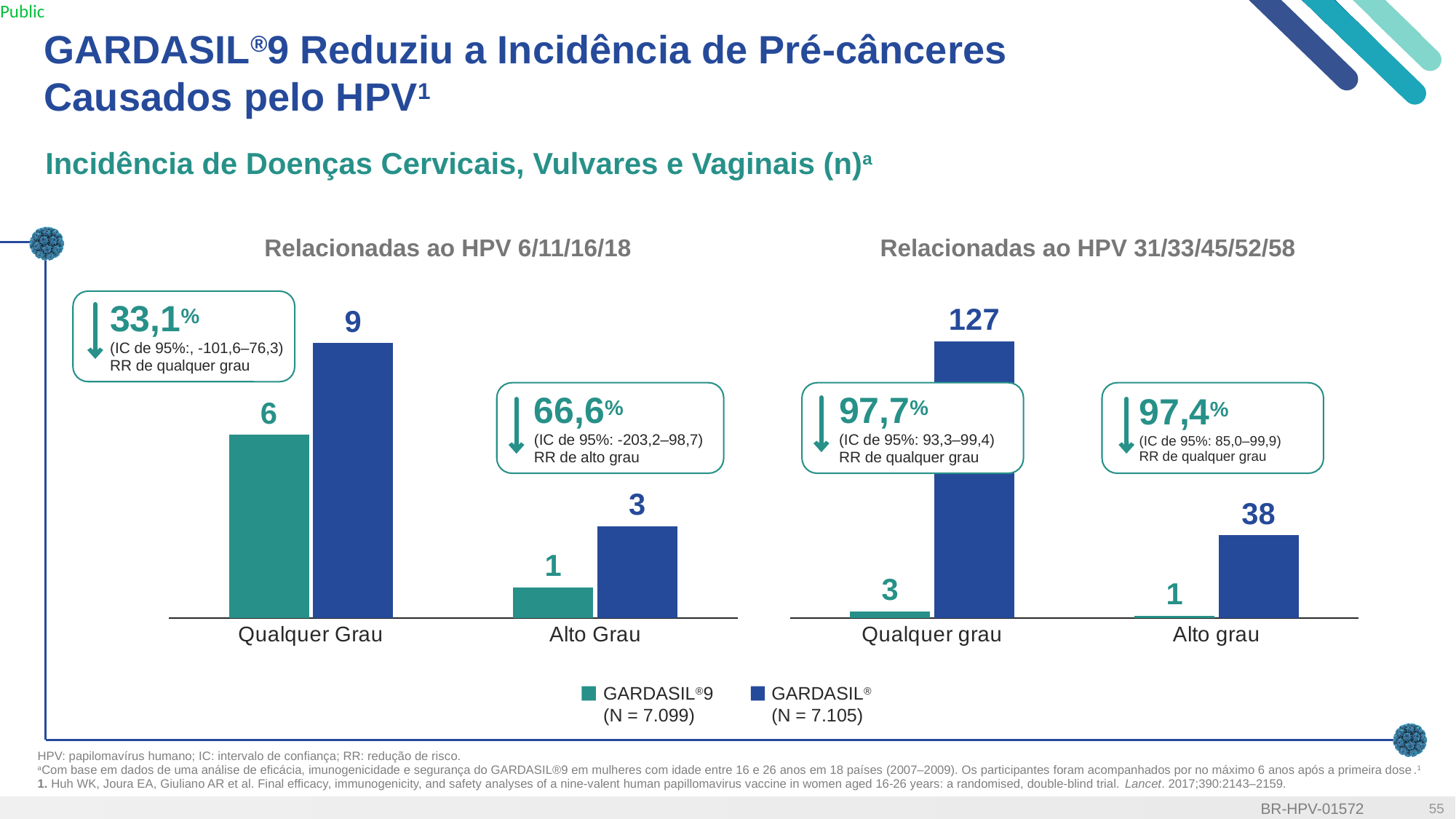
In the chart 'Relacionadas ao HPV 6/11/16/18', what is the value for GARDASIL®9 in the 'Qualquer Grau' category? 6 In the chart 'Relacionadas ao HPV 31/33/45/52/58', what is the value for GARDASIL® in the 'Qualquer grau' category? 127 In the chart 'Relacionadas ao HPV 31/33/45/52/58', which bar is the highest? GARDASIL® in Qualquer grau (127) How many series does the legend list for the charts on this slide? 2 What type of chart is used for 'Relacionadas ao HPV 31/33/45/52/58'? Bar chart In the chart 'Relacionadas ao HPV 6/11/16/18', what is the difference between GARDASIL® and GARDASIL®9 in the 'Qualquer Grau' category? 3 In the chart 'Relacionadas ao HPV 31/33/45/52/58', is the GARDASIL® value for 'Alto grau' larger or smaller than the GARDASIL® value for 'Qualquer grau'? smaller How many categories are shown on the x axis of the chart 'Relacionadas ao HPV 6/11/16/18'? 2 In the chart 'Relacionadas ao HPV 6/11/16/18', which series has the larger value in the 'Alto Grau' category? GARDASIL® In the chart 'Relacionadas ao HPV 31/33/45/52/58', what is the difference between GARDASIL® and GARDASIL®9 in the 'Qualquer grau' category? 124 In the chart 'Relacionadas ao HPV 6/11/16/18', what is the value for GARDASIL® in the 'Alto Grau' category? 3 In the chart 'Relacionadas ao HPV 31/33/45/52/58', what is the value for GARDASIL®9 in the 'Alto grau' category? 1